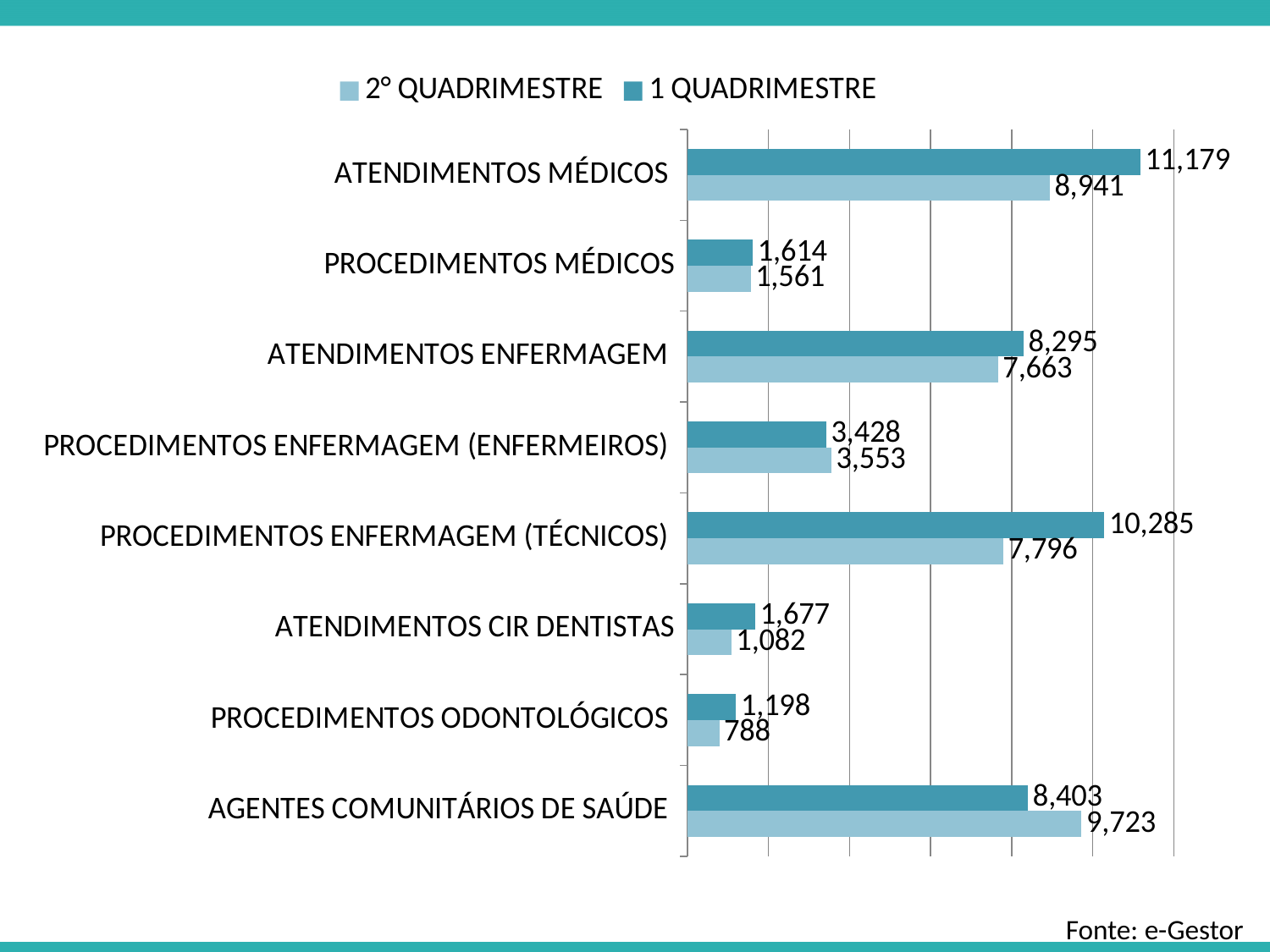
Which category has the lowest value in the 2° QUADRIMESTRE series? PROCEDIMENTOS ODONTOLÓGICOS Which category has the highest value in the 1 QUADRIMESTRE series? ATENDIMENTOS MÉDICOS How many series does the legend list? 2 How many categories are shown on the chart? 8 What is the value for PROCEDIMENTOS ODONTOLÓGICOS in the 2° QUADRIMESTRE series? 788 For PROCEDIMENTOS ENFERMAGEM (ENFERMEIROS), which series has the larger value, 1 QUADRIMESTRE or 2° QUADRIMESTRE? 2° QUADRIMESTRE What source is cited at the bottom of the slide? Fonte: e-Gestor What is the difference between the 1 QUADRIMESTRE and 2° QUADRIMESTRE values for PROCEDIMENTOS ENFERMAGEM (TÉCNICOS)? 2,489 What is the value for ATENDIMENTOS MÉDICOS in the 1 QUADRIMESTRE series? 11,179 What kind of chart is shown on the slide? Bar chart What is the difference between the 1 QUADRIMESTRE and 2° QUADRIMESTRE values for ATENDIMENTOS CIR DENTISTAS? 595 What is the value for AGENTES COMUNITÁRIOS DE SAÚDE in the 2° QUADRIMESTRE series? 9,723